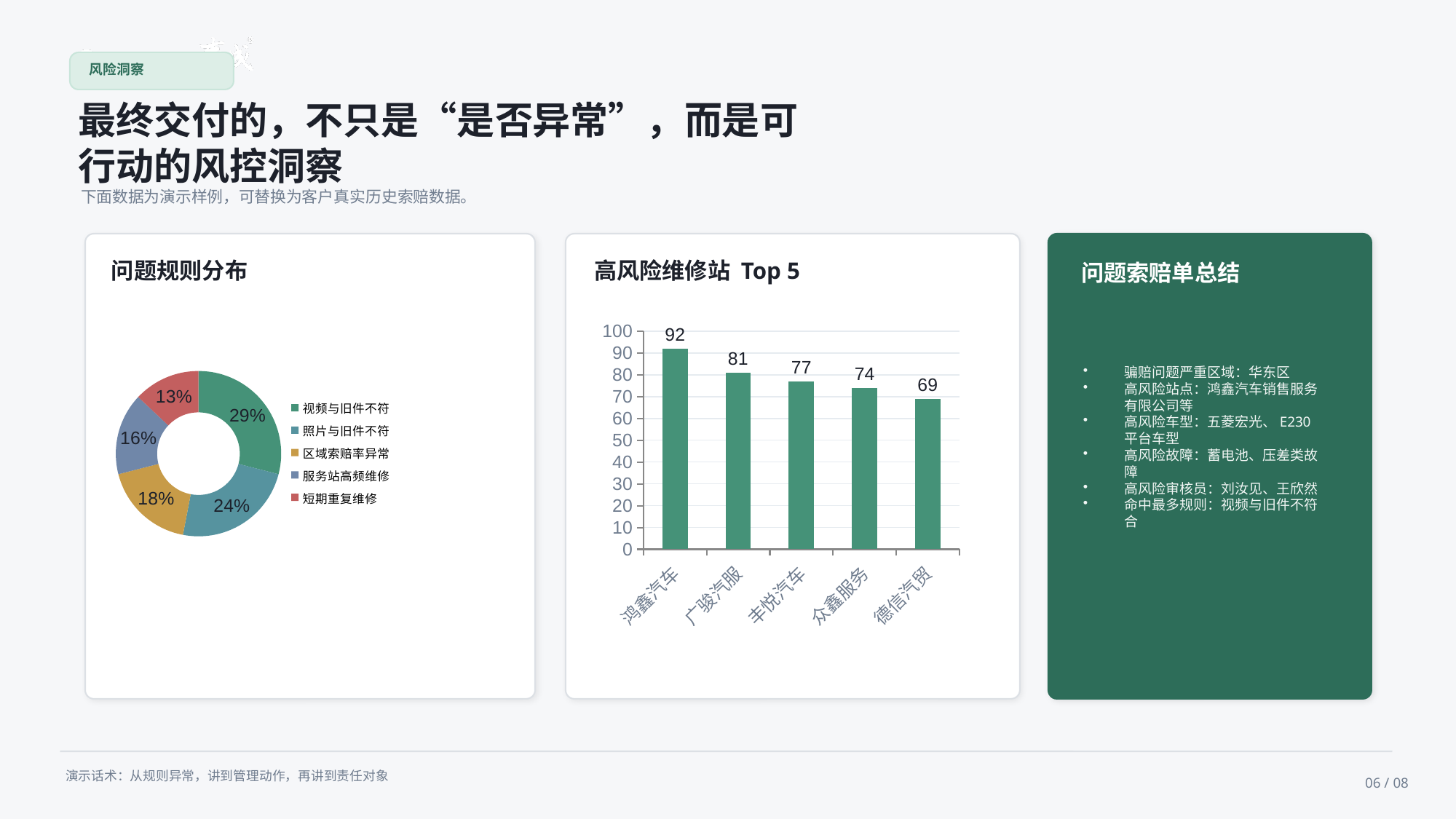
What kind of chart is the 高风险维修站 Top 5 chart? Bar chart In the 问题规则分布 chart, what share does 服务站高频维修 have? 16% In the 高风险维修站 Top 5 chart, what is the value for 丰悦汽车? 77 In the 高风险维修站 Top 5 chart, do the values rise or fall from left to right? Fall In the 高风险维修站 Top 5 chart, what is the value for 德信汽贸? 69 How many categories does the 问题规则分布 chart show? 5 In the 问题规则分布 chart, what share does 视频与旧件不符 have? 29% In the 问题规则分布 chart, which category has the largest share? 视频与旧件不符 What kind of chart is the 问题规则分布 chart? Doughnut chart In the 问题规则分布 chart, which category has the smallest share? 短期重复维修 In the 高风险维修站 Top 5 chart, which station has the highest value? 鸿鑫汽车 In the 高风险维修站 Top 5 chart, what is the difference between 鸿鑫汽车 and 广骏汽服? 11